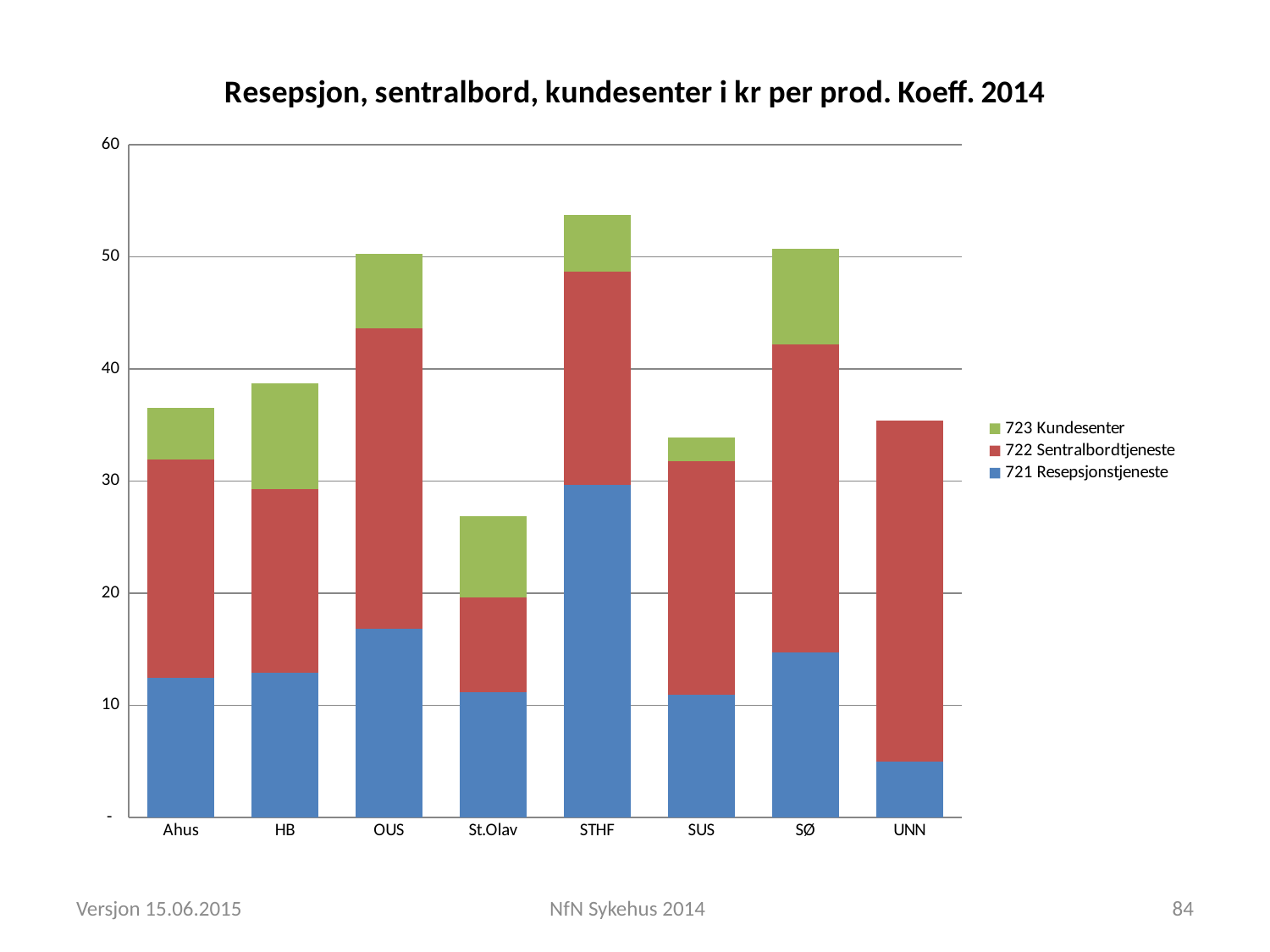
How many series does the legend list? 3 Is the total stacked value for St.Olav greater or less than 30? less Which hospital has the highest total stacked bar? STHF Which has the larger total stacked bar, STHF or SUS? STHF Which hospital has the smallest 721 Resepsjonstjeneste segment? UNN Is the total stacked value for STHF greater or less than 50? greater Which hospital has the lowest total stacked bar? St.Olav What is the title of the chart? Resepsjon, sentralbord, kundesenter i kr per prod. Koeff. 2014 How many hospitals (categories) are shown on the x axis? 8 Is the 721 Resepsjonstjeneste value for UNN greater or less than 10? less What kind of chart is shown on the slide? Stacked bar chart Which hospital has the largest 721 Resepsjonstjeneste segment? STHF